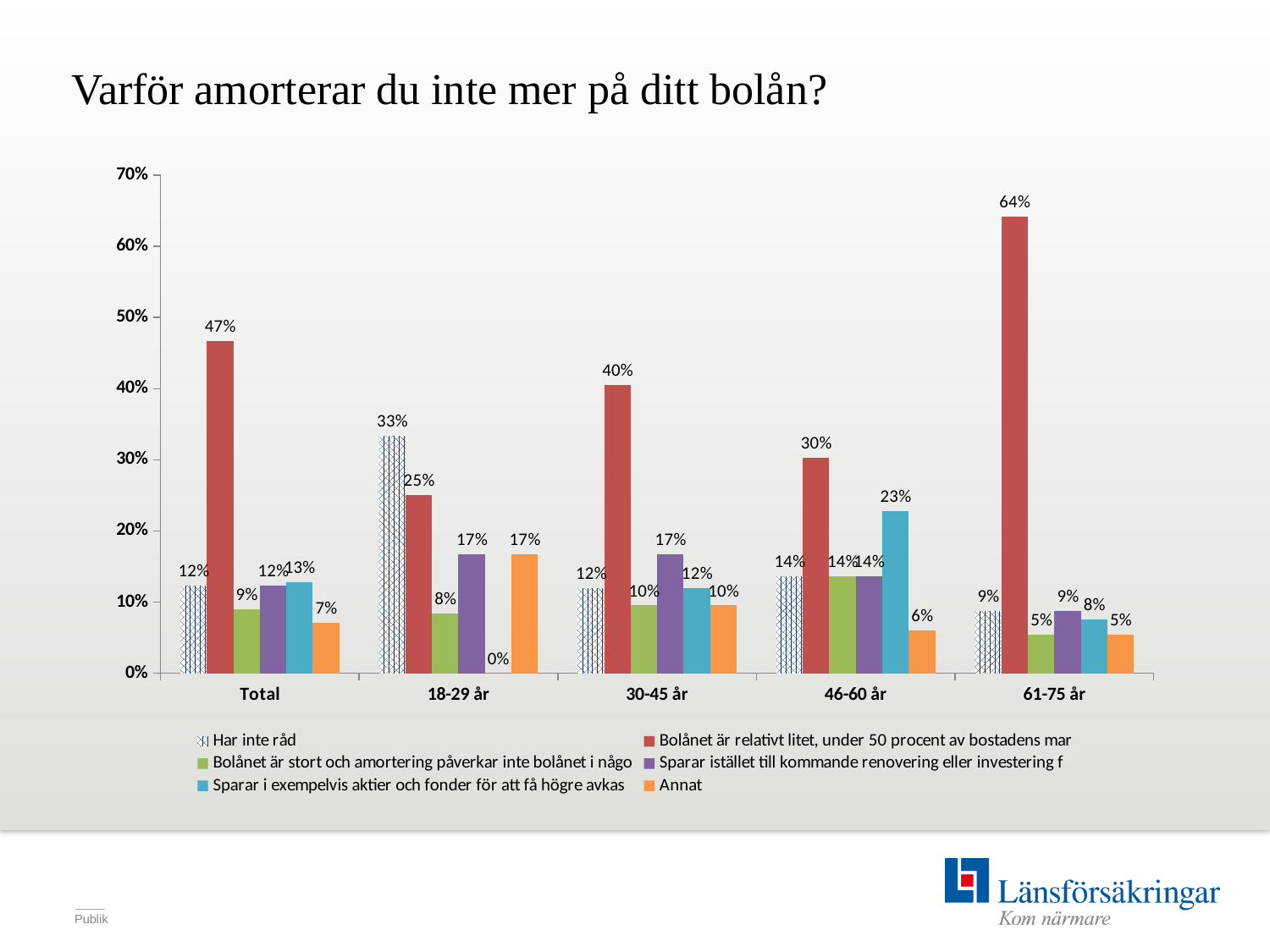
What is the value for "Har inte råd" in the 18-29 år group? 33% What is the value for "Bolånet är relativt litet, under 50 procent av bostadens mar" in the 61-75 år group? 64% Which series has the lowest value in the 18-29 år group? Sparar i exempelvis aktier och fonder för att få högre avkas What is the value for "Annat" in the Total group? 7% What is the value for "Sparar i exempelvis aktier och fonder för att få högre avkas" in the 46-60 år group? 23% In the 18-29 år group, which is larger: "Har inte råd" or "Bolånet är relativt litet, under 50 procent av bostadens mar"? Har inte råd What kind of chart is shown on the slide? Bar chart How many series does the legend list? 6 How many age groups (categories) are shown on the x axis? 5 What is the difference between the "Bolånet är relativt litet" values for 61-75 år and 18-29 år? 39 percentage points What is the title of the slide? Varför amorterar du inte mer på ditt bolån? Which age group has the highest value for "Bolånet är relativt litet, under 50 procent av bostadens mar"? 61-75 år